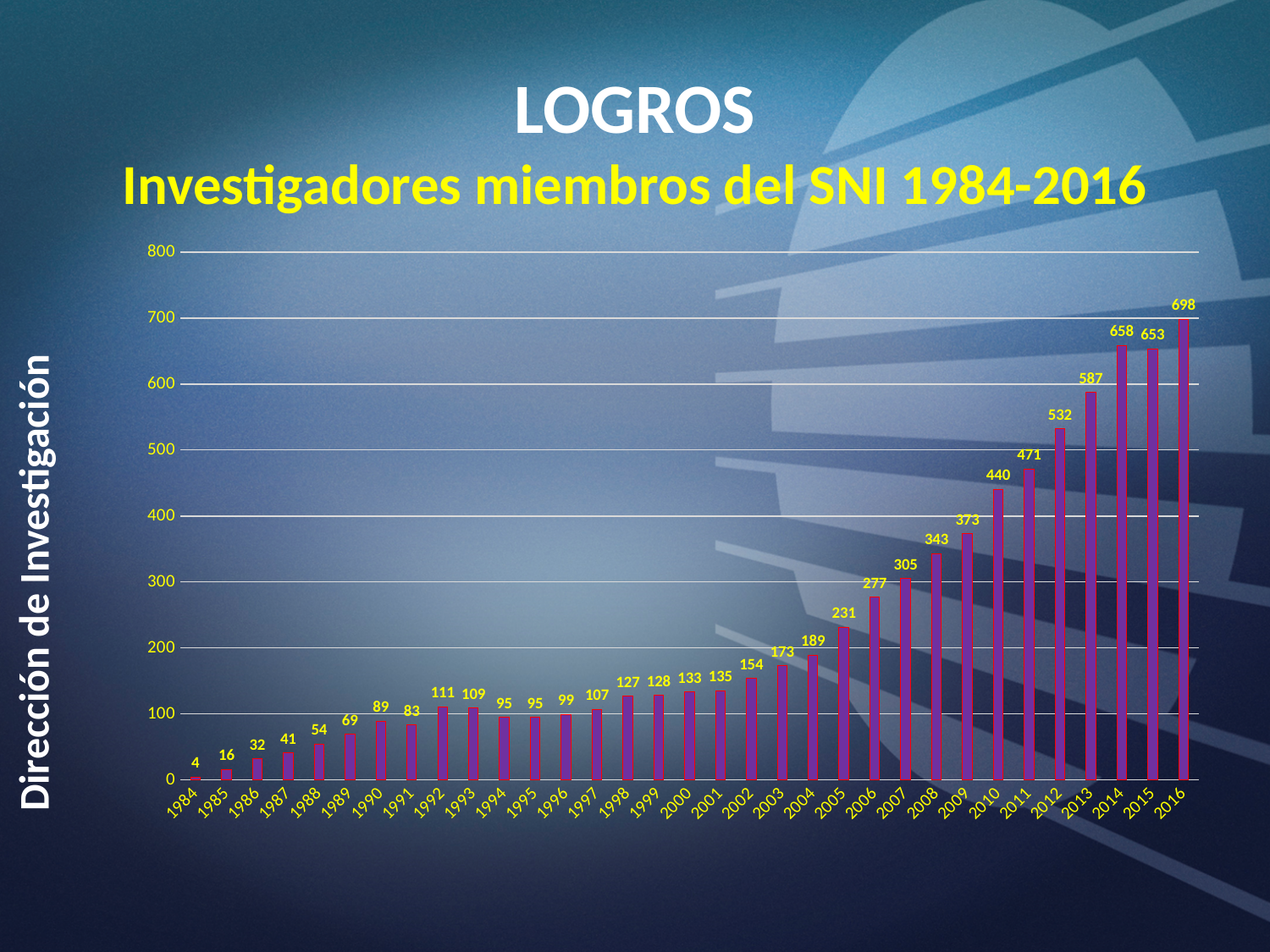
Is the value for 2010 greater or less than 400? greater What is the value for 2016? 698 How many years are shown on the x axis? 33 What is the value for 1984? 4 Which year has the lowest value? 1984 What is the value for 2012? 532 Do the values generally rise or fall from 1984 to 2016? rise What is the value for 2005? 231 What is the difference between the values for 2016 and 2015? 45 Which is larger, the value for 1992 or the value for 1993? 1992 What kind of chart is this? bar chart Which year has the highest value? 2016